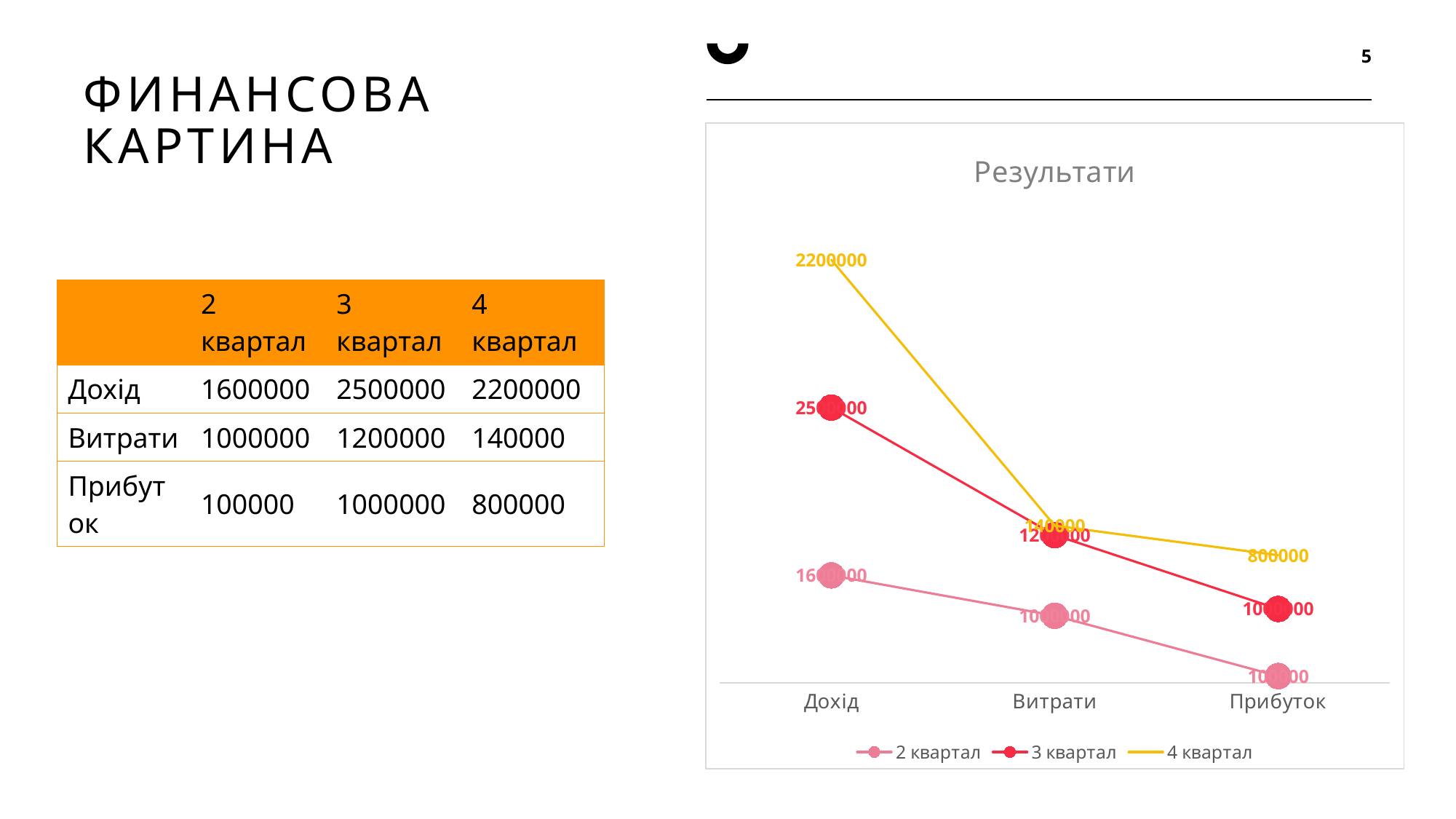
Do the values of the 2 квартал series rise or fall from Дохід to Прибуток? fall Which category has the highest value for the 4 квартал series? Дохід What kind of chart is shown on the slide? line chart What is the value of Дохід for 3 квартал? 2500000 How many categories are shown on the x axis of the chart? 3 What is the difference between Дохід for 3 квартал and Дохід for 2 квартал? 900000 What is the value of Прибуток for 2 квартал? 100000 Which is larger: Прибуток for 3 квартал or Прибуток for 2 квартал? 3 квартал What is the value of Дохід for 4 квартал? 2200000 What is the value of Прибуток for 4 квартал? 800000 What is the title of the chart? Результати How many series does the legend of the chart list? 3